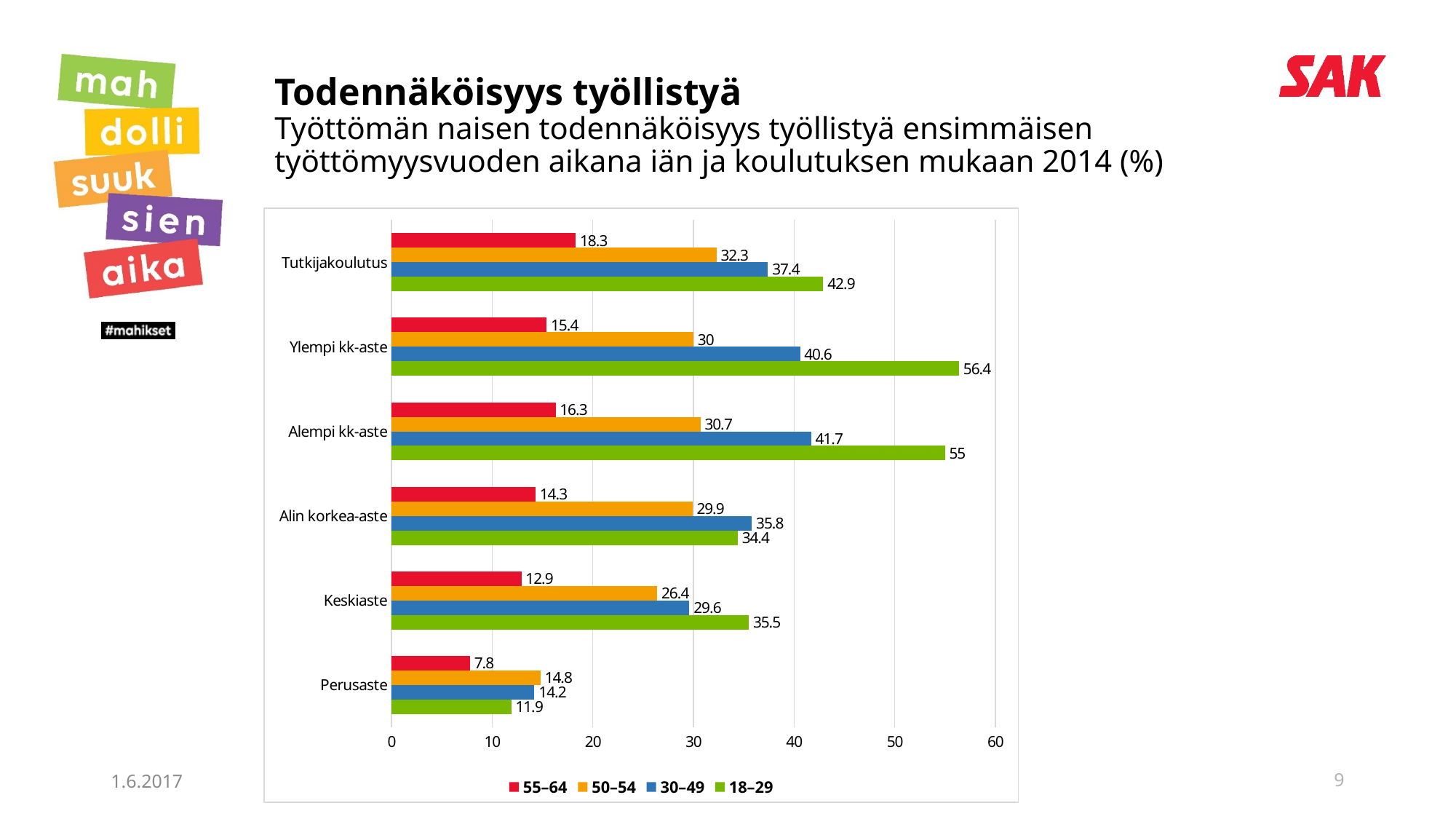
What kind of chart is shown on the slide? Bar chart In the Alin korkea-aste category, which is larger: the 30–49 value or the 18–29 value? 30–49 What is the value for the 50–54 series in the Keskiaste category? 26.4 What is the value for the 55–64 series in the Perusaste category? 7.8 How many series does the legend list? 4 Which colour represents the 18–29 series in the legend? Green How many education categories are shown on the chart? 6 What is the difference between the 18–29 and 55–64 values in the Tutkijakoulutus category? 24.6 What is the value for the 30–49 series in the Alempi kk-aste category? 41.7 What is the value for the 18–29 series in the Ylempi kk-aste category? 56.4 Which category has the lowest value for the 50–54 series? Perusaste Which category has the highest value for the 18–29 series? Ylempi kk-aste